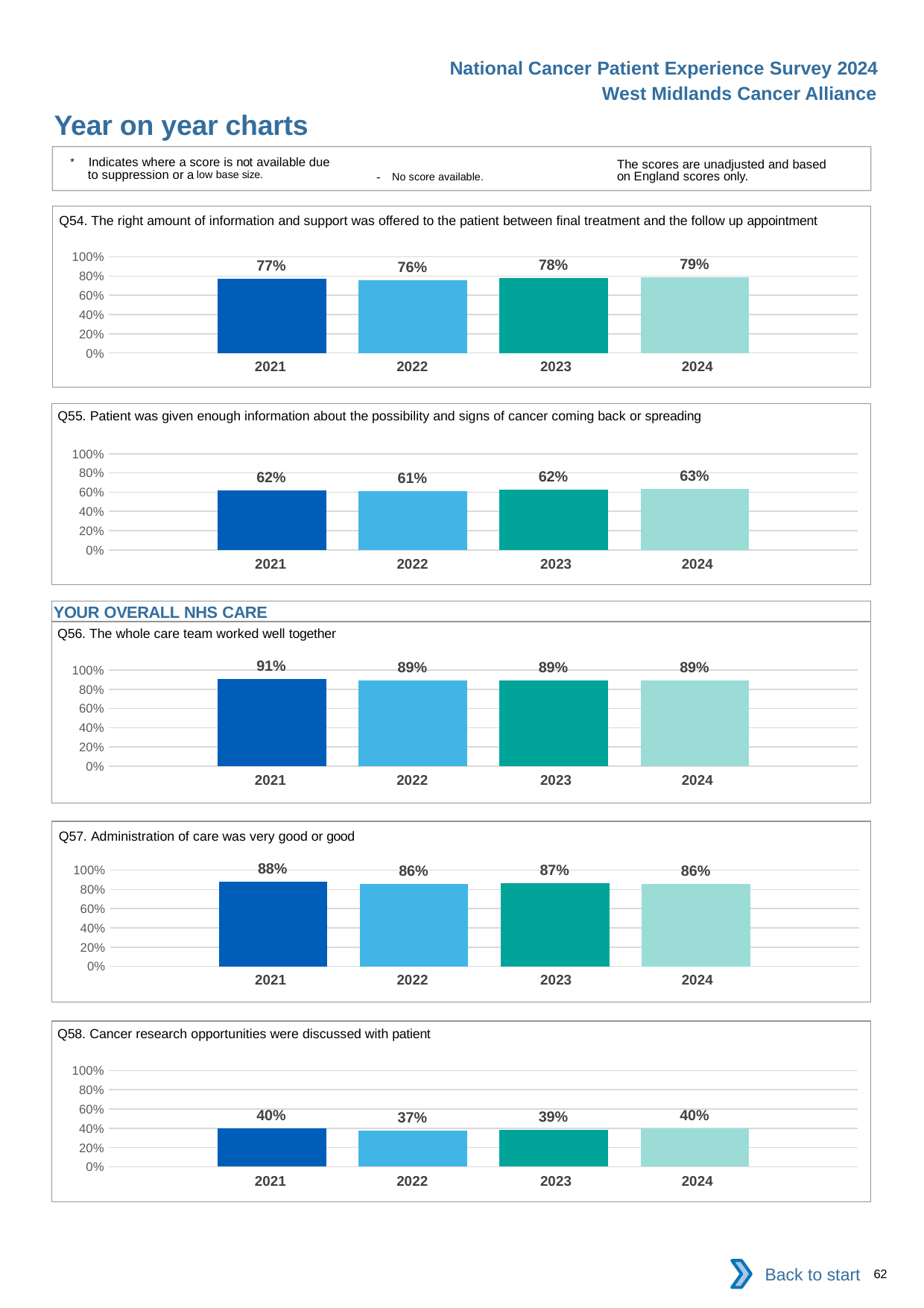
In the Q54 chart, do the values rise or fall from 2022 to 2024? rise What is the section heading shown above the Q56 chart? YOUR OVERALL NHS CARE In the Q54 chart, what is the value for 2024? 79% In the Q58 chart, is the value for 2023 greater or less than 60%? less In the Q56 chart, which year has the highest value? 2021 In the Q55 chart, what is the value for 2024? 63% What type of chart is used for Q56? bar chart In the Q55 chart, which year has the lowest value? 2022 In the Q57 chart, which is larger, the value for 2021 or the value for 2023? 2021 In the Q56 chart, what is the difference between the 2021 and 2022 values? 2 percentage points In the Q58 chart, what is the value for 2022? 37% How many years are shown in the Q54 chart? 4